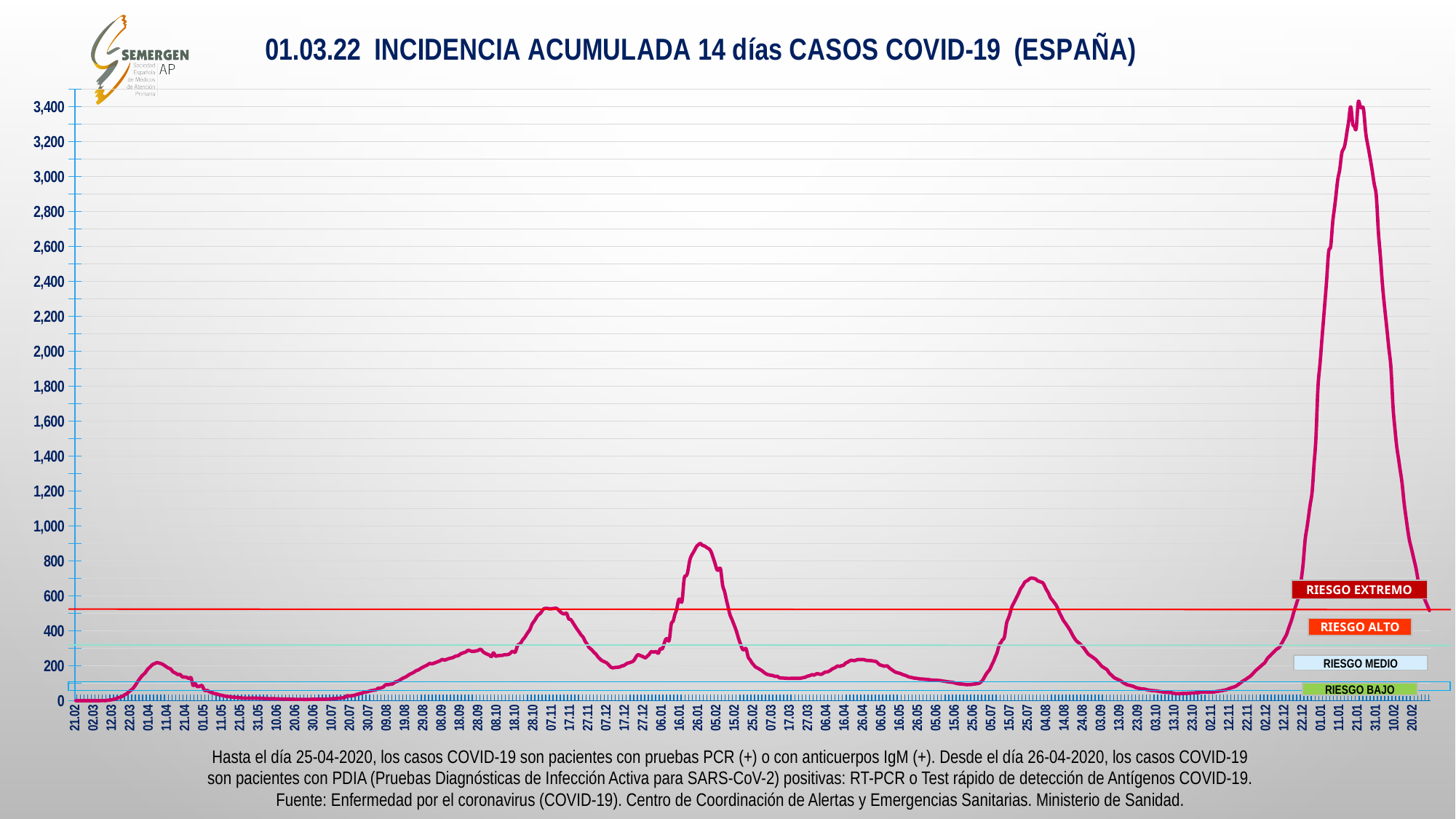
How many risk-level labels (RIESGO) are shown on the right side of the chart? 4 Does the line rise or fall between 21.01 and 20.02? fall Is the value of the line at 17.03 greater or less than 200? less Around which x-axis date does the line reach its highest value? 21.01 What is the title of the chart? 01.03.22 INCIDENCIA ACUMULADA 14 días CASOS COVID-19 (ESPAÑA) Is the value of the line at 07.11 greater or less than 400? greater Is the value of the line at 25.07 greater or less than 600? greater What kind of chart is shown on the slide? line chart Does the line rise or fall between 12.12 and 21.01? rise